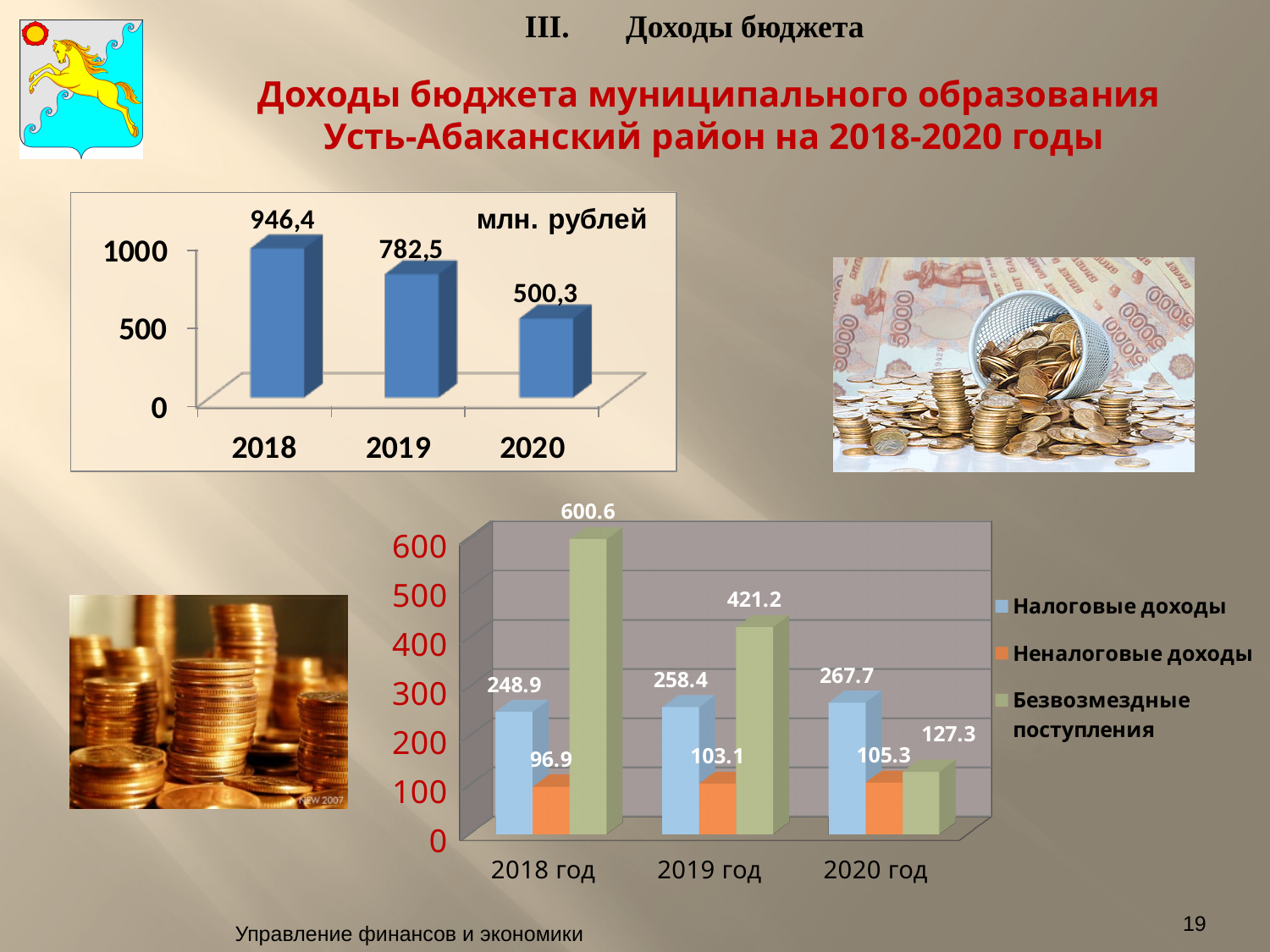
In the bottom chart, what is the value of Безвозмездные поступления for 2018 год? 600.6 In the bottom chart, how many series does the legend list? 3 In the top-left chart, which year has the lowest value? 2020 In the bottom chart, what is the value of Неналоговые доходы for 2019 год? 103.1 In the top-left chart, what is the value for 2018? 946,4 In the bottom chart, what is the difference between Безвозмездные поступления in 2018 год and 2020 год? 473.3 In the top-left chart, what is the difference between the 2018 and 2019 values? 163,9 In the top-left chart, what is the value for 2020? 500,3 In the bottom chart, which is larger for 2020 год: Налоговые доходы or Безвозмездные поступления? Налоговые доходы In the top-left chart, do the values rise or fall from 2018 to 2020? fall In the top-left chart, what unit is shown for the values? млн. рублей What kind of chart is the bottom chart? bar chart